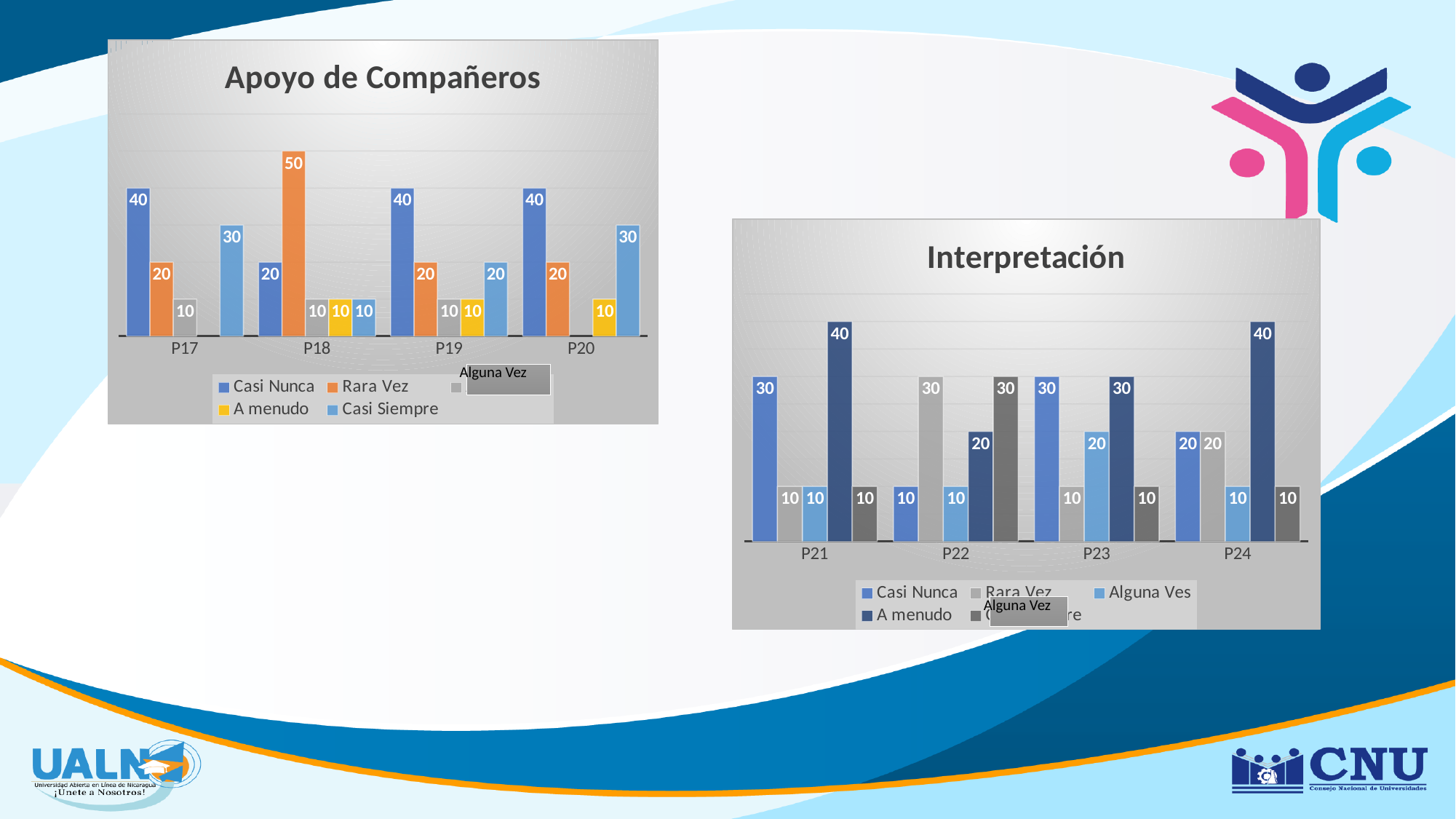
What type of chart is 'Apoyo de Compañeros'? Bar chart How many categories are shown on the x axis of the 'Apoyo de Compañeros' chart? 4 How many series does the legend of the 'Interpretación' chart list? 5 In the 'Apoyo de Compañeros' chart, which is larger for P18: Casi Nunca or Rara Vez? Rara Vez In the 'Apoyo de Compañeros' chart, which category has the highest Rara Vez value? P18 In the 'Apoyo de Compañeros' chart, what is the value of Casi Siempre for P17? 30 In the 'Apoyo de Compañeros' chart, what is the value of Rara Vez for P18? 50 In the 'Interpretación' chart, what is the value of Rara Vez for P22? 30 In the 'Interpretación' chart, what is the difference between the A menudo value and the Casi Nunca value for P21? 10 In the 'Apoyo de Compañeros' chart, what is the difference between the Casi Nunca value and the Rara Vez value for P19? 20 In the 'Interpretación' chart, which category has the lowest Casi Nunca value? P22 In the 'Interpretación' chart, what is the value of A menudo for P24? 40